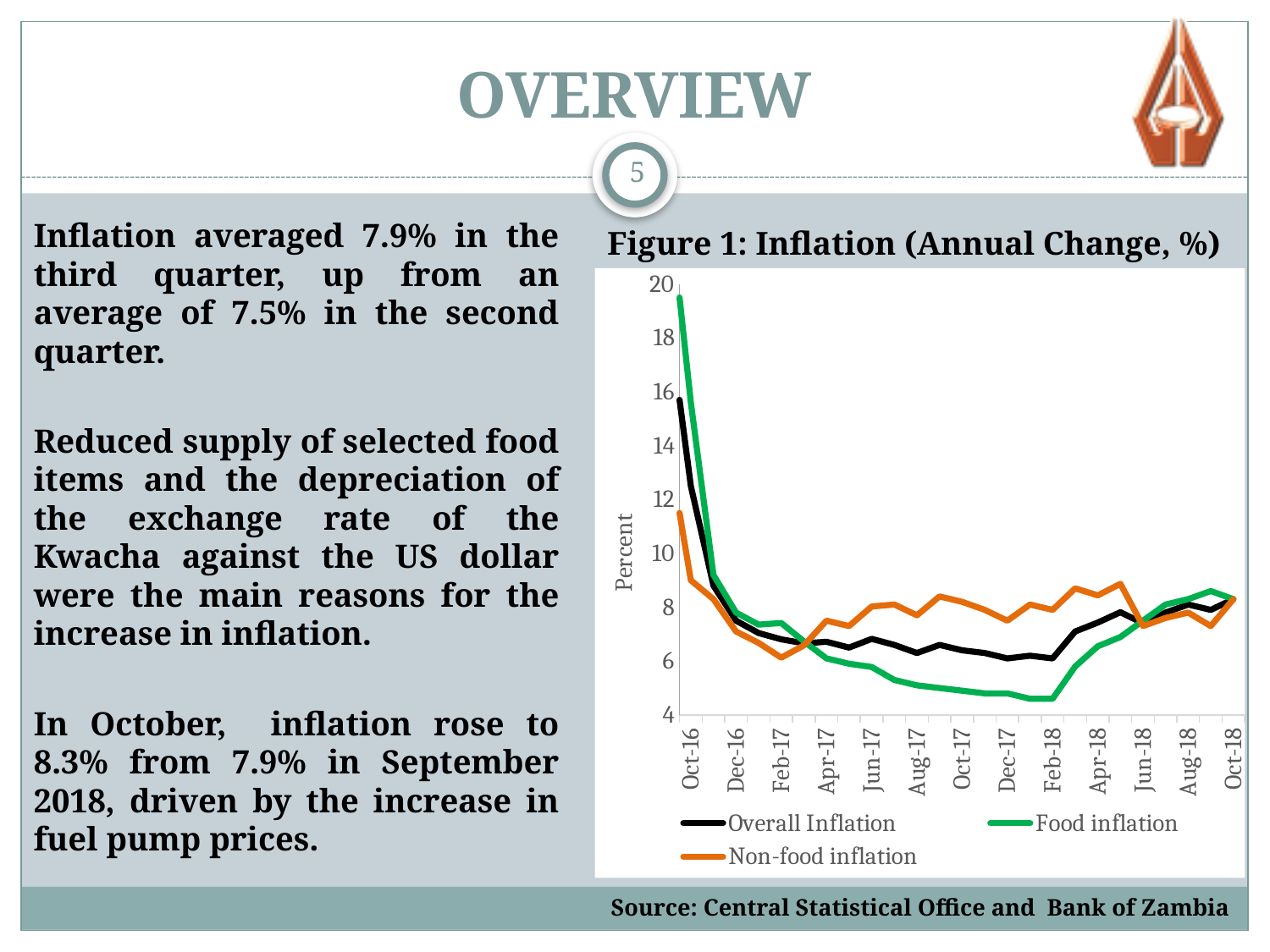
Which series has the highest value in Oct-16? Food inflation Is the value for Food inflation in Feb-18 greater or less than 6? less What is the label on the vertical axis of the chart? Percent How many series does the legend of Figure 1 list? 3 Is the value for Overall Inflation in Oct-16 greater or less than 14? greater Is the value for Food inflation in Oct-16 greater or less than 18? greater Which series has the lowest value in Feb-18? Food inflation Does Food inflation rise or fall between Oct-16 and Feb-18? Fall In Oct-17, which is larger: Non-food inflation or Overall Inflation? Non-food inflation What kind of chart is Figure 1? Line chart What is the title of the chart? Figure 1: Inflation (Annual Change, %)